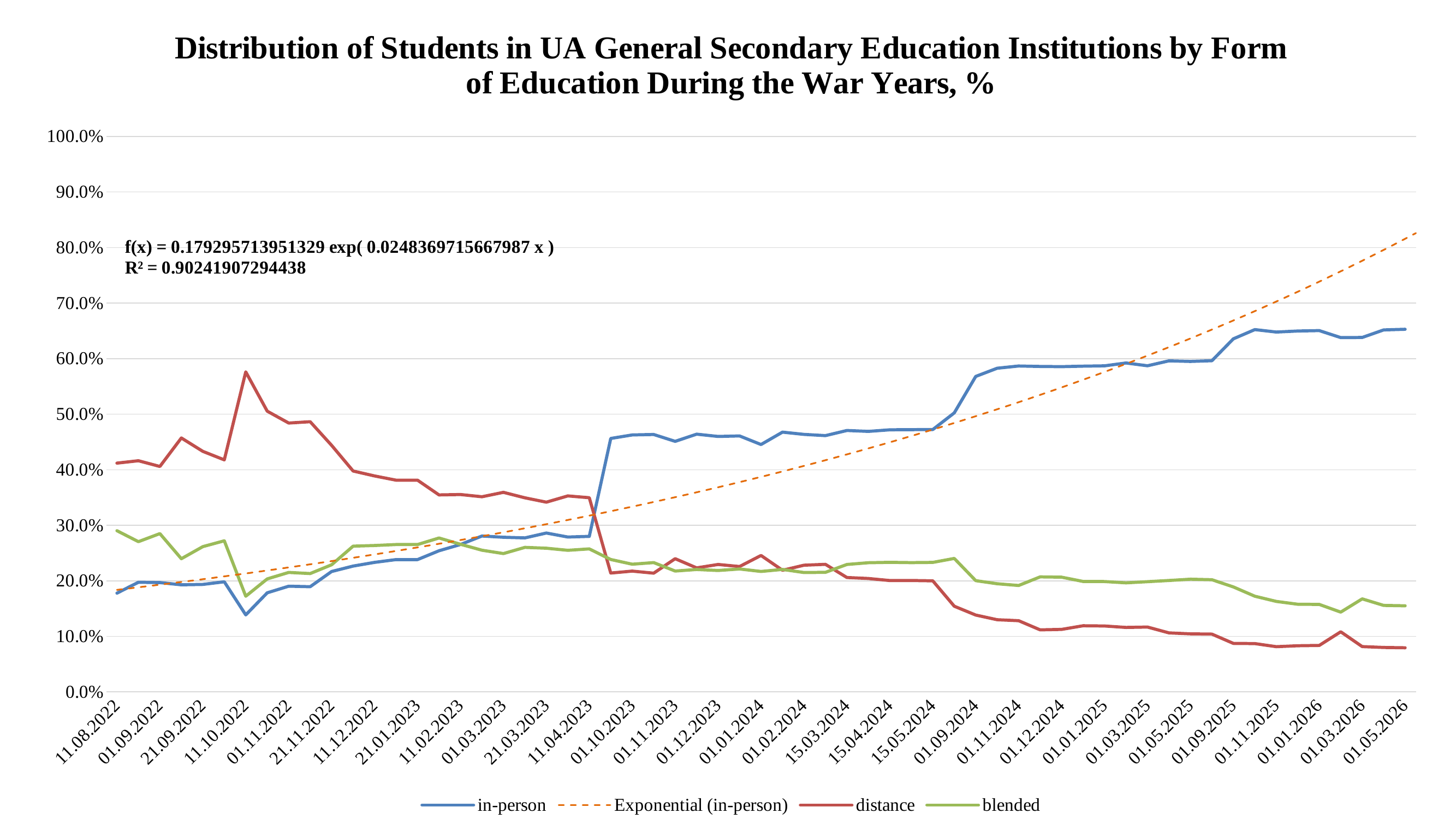
Is the value for distance at 11.10.2022 greater or less than 50%? greater Does the distance series rise or fall overall from 11.08.2022 to 01.05.2026? fall Is the value for distance at 01.05.2026 greater or less than 10%? less How many entries does the legend list? 4 What kind of chart is shown on the slide? line chart Is the value for blended at 01.05.2026 greater or less than 20%? less Which series has the highest value at 11.08.2022? distance Does the in-person series rise or fall overall from 11.08.2022 to 01.05.2026? rise At 01.05.2026, which is larger: blended or distance? blended What R² value is printed on the chart for the exponential trendline? 0.90241907294438 Which series has the lowest value at 01.05.2026? distance